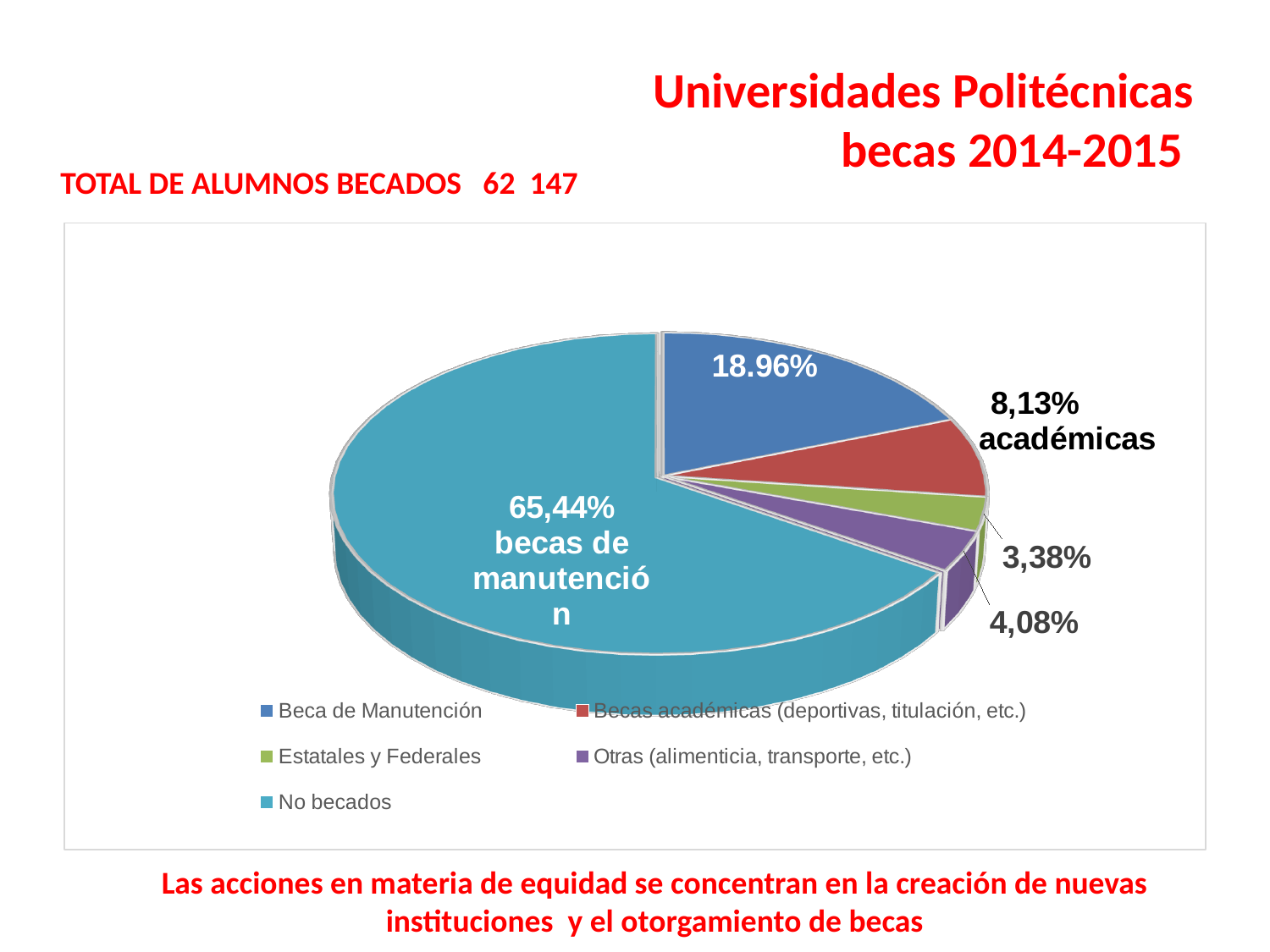
What percentage is shown for the Otras (alimenticia, transporte, etc.) slice? 4,08% How many slices does the pie chart have? 5 What percentage is shown for the Estatales y Federales slice? 3,38% What is the difference between the Beca de Manutención slice (18.96%) and the Becas académicas slice (8,13%)? 10,83% How many entries does the legend list? 5 What kind of chart is shown on the slide? pie chart What percentage is shown for the Beca de Manutención slice? 18.96% What percentage is printed on the largest slice of the pie? 65,44% Which slice is larger, Beca de Manutención or Becas académicas (deportivas, titulación, etc.)? Beca de Manutención What percentage is shown for the Becas académicas (deportivas, titulación, etc.) slice? 8,13% What total number of students with scholarships is stated above the chart? 62 147 Which legend category has the smallest slice of the pie? Estatales y Federales